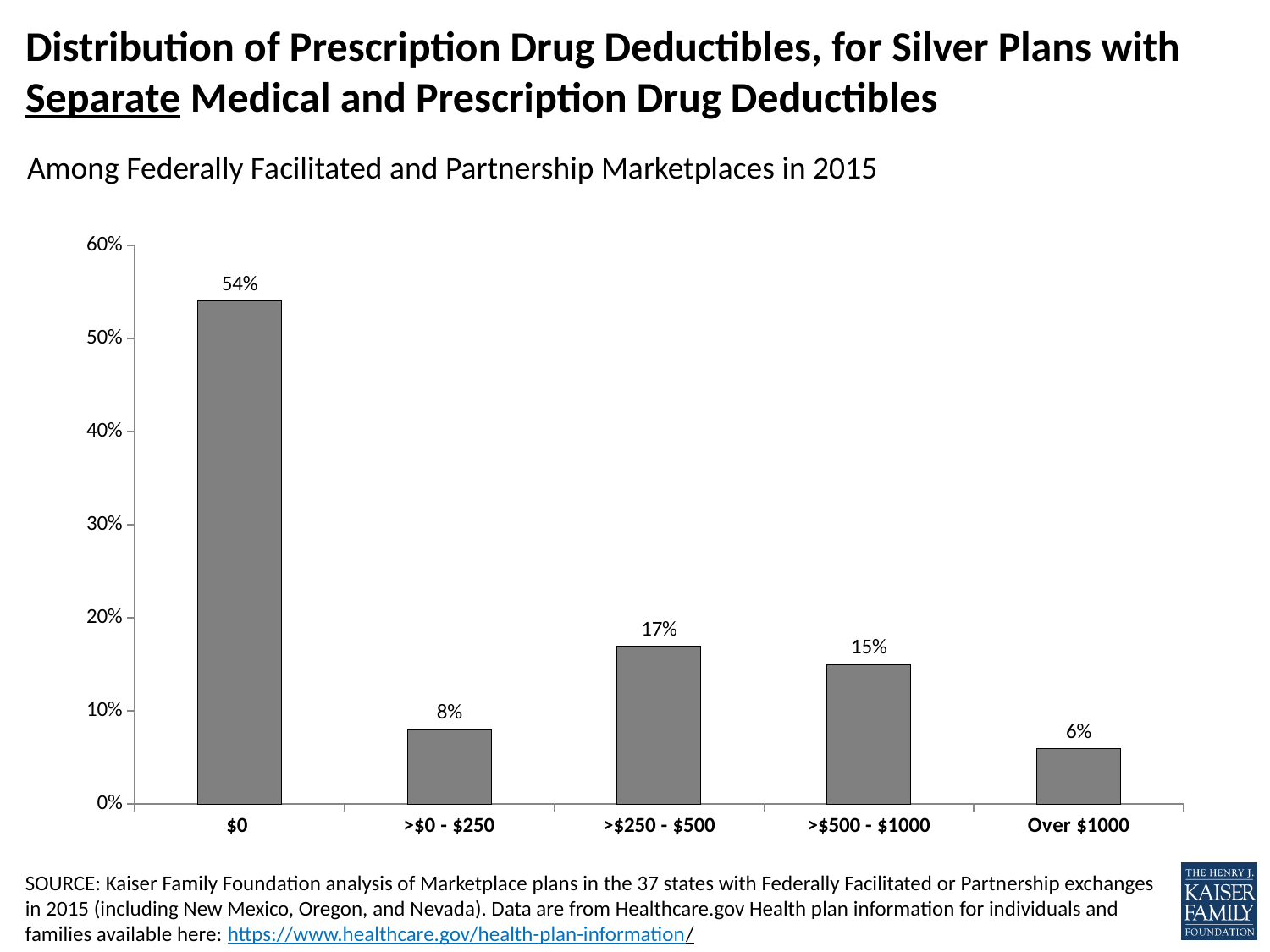
Which deductible category has the lowest share of plans? Over $1000 What kind of chart is shown on the slide? Bar chart What is the difference in percentage points between the $0 category and the >$500 - $1000 category? 39 percentage points Which is larger, the value for >$250 - $500 or the value for >$500 - $1000? >$250 - $500 Which deductible category has the highest share of plans? $0 What percentage of silver plans with separate deductibles have a $0 prescription drug deductible? 54% What is the value shown for the Over $1000 category? 6% What is the value shown for the >$0 - $250 category? 8% What is the highest value shown on the y axis? 60% Is the value for the $0 category greater or less than 50%? greater What is the value shown for the >$250 - $500 category? 17% How many deductible categories are shown on the x axis? 5